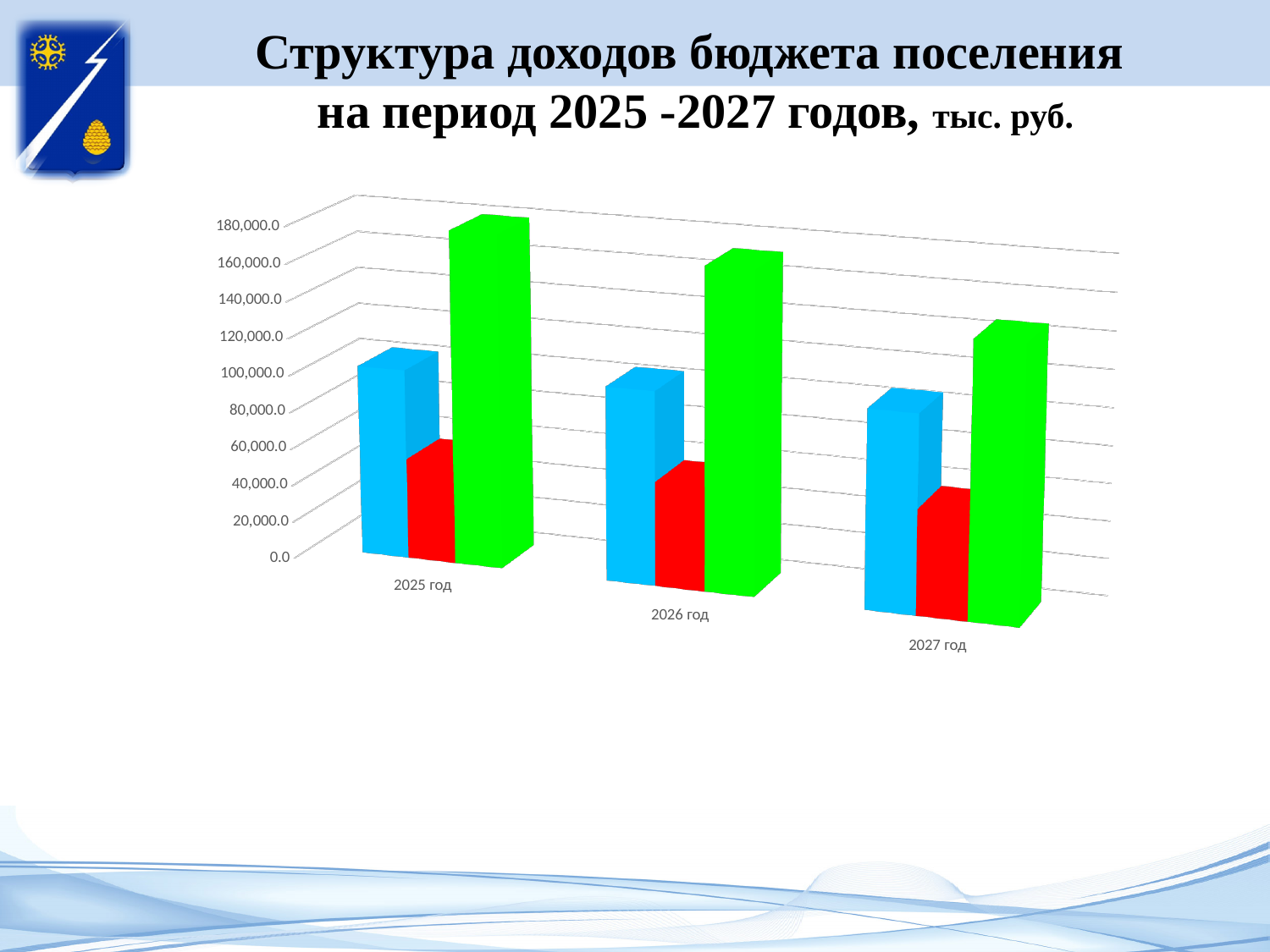
What is the title of the slide containing the chart? Структура доходов бюджета поселения на период 2025 -2027 годов, тыс. руб. Which year has the tallest green bar? 2025 год Do the green bars rise or fall from 2025 год to 2027 год? fall Which year has the shortest green bar? 2027 год What kind of chart is shown on the slide? bar chart How many year categories are shown on the x axis of the chart? 3 How many bars are plotted for each year in the chart? 3 In 2026 год, which bar is taller, the green one or the blue one? the green one In 2027 год, which bar is taller, the blue one or the red one? the blue one Is the value of the green bar for 2025 год greater or less than 160,000.0? greater